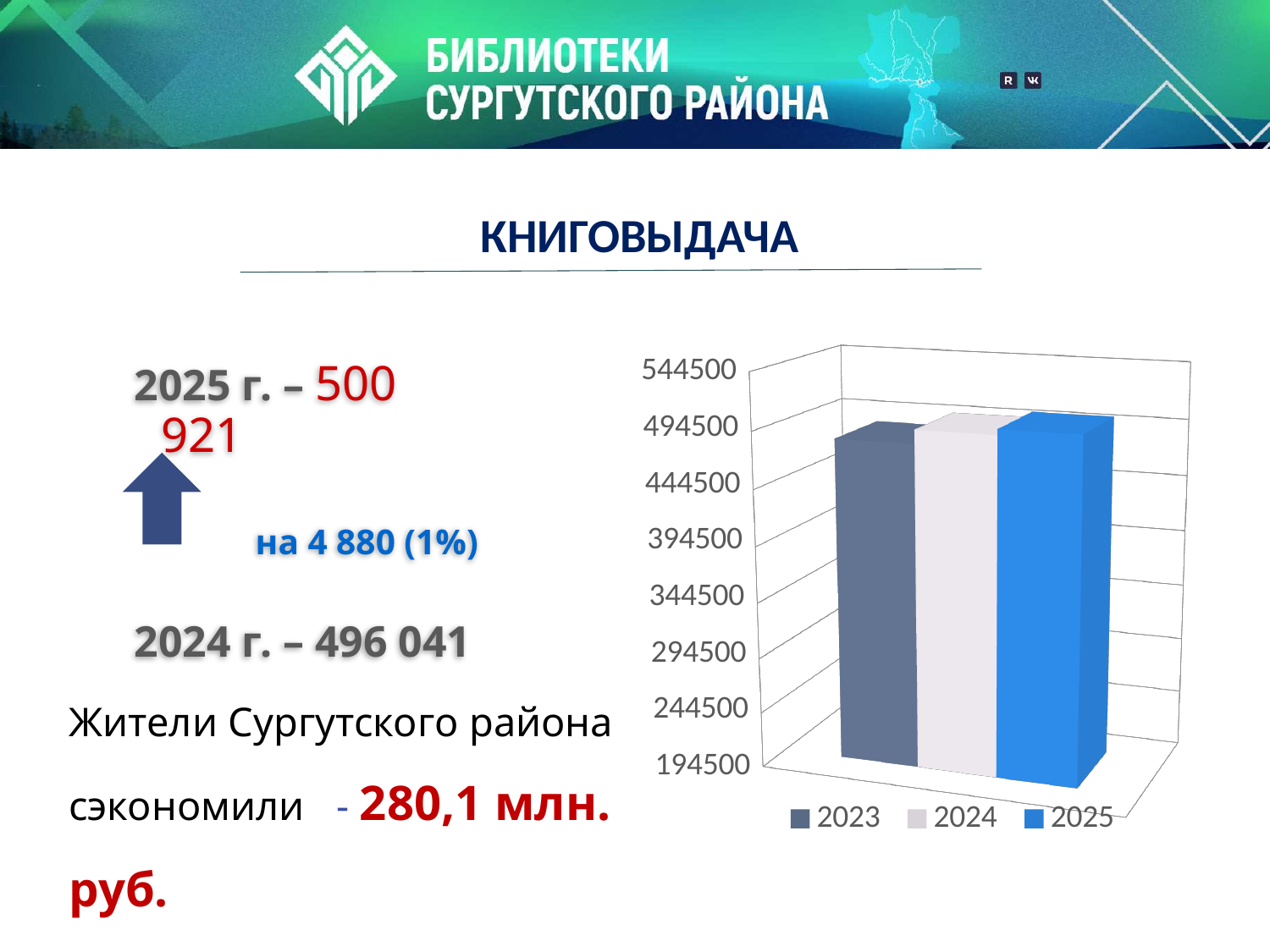
Is the value for 2024 in the chart greater or less than 544500? less What is the lowest value shown on the chart's vertical axis? 194500 How many entries does the chart legend list? 3 According to the slide, what was the book lending (книговыдача) figure for 2024? 496 041 Is the value for 2025 in the chart greater or less than 394500? greater According to the slide, what was the book lending (книговыдача) figure for 2025? 500 921 Which years are listed in the chart legend? 2023, 2024, 2025 Is the value for 2023 in the chart greater or less than 444500? greater How many bars are plotted in the chart? 3 What colour is the bar for 2025 in the chart? blue What kind of chart is shown on the slide? bar chart By how much did the book lending figure increase from 2024 to 2025, according to the slide? 4 880